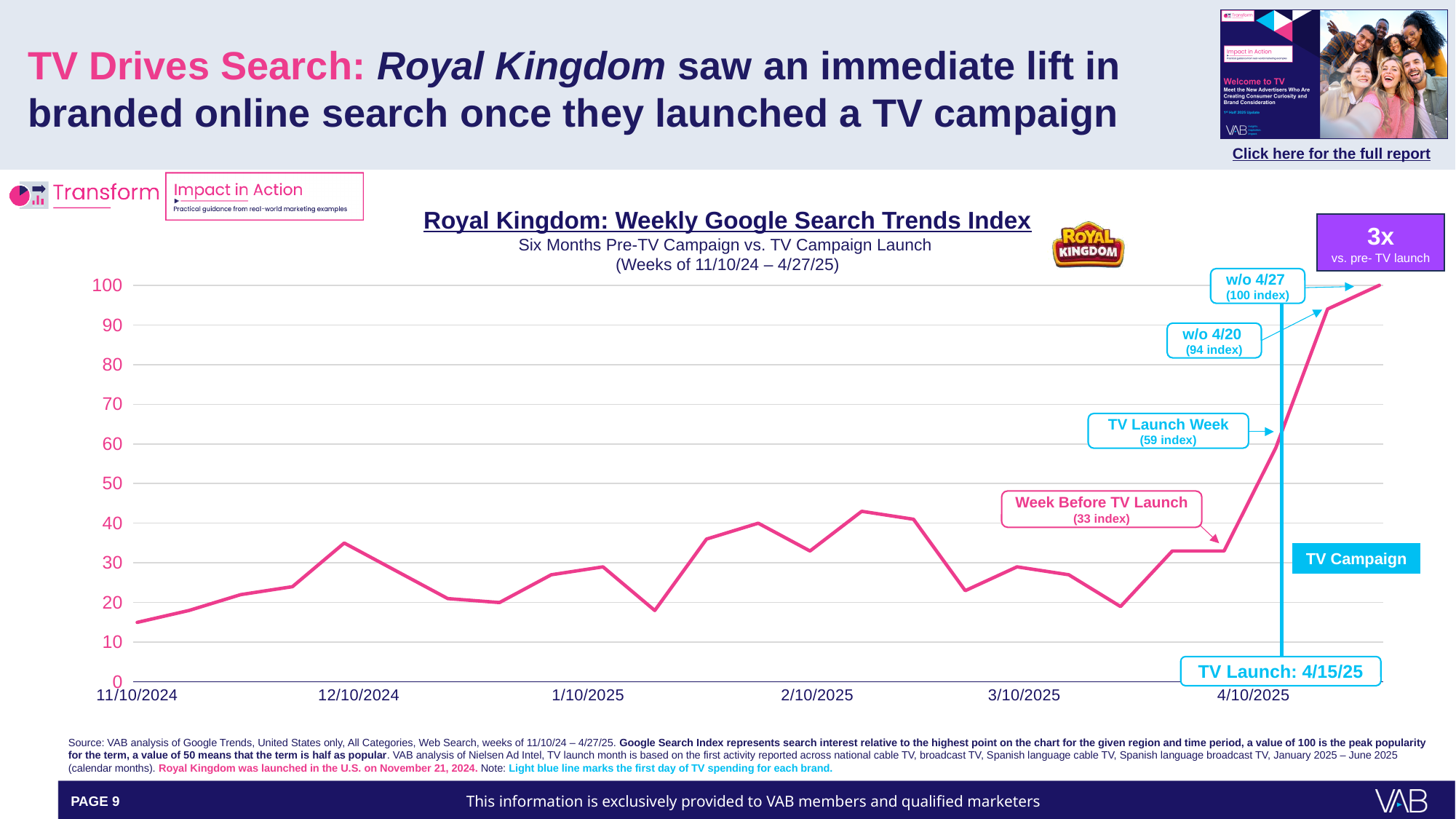
What is the search index value for the TV Launch Week? 59 index By how much did the search index rise from the Week Before TV Launch to the TV Launch Week? 26 Which week has the highest search index value on the chart? w/o 4/27 What kind of chart is shown on the slide? Line chart What is the search index value for the week of 4/20? 94 index Is the search index value at 11/10/2024 greater or less than 20? less What is the search index value for the Week Before TV Launch? 33 index What is the search index value for the week of 4/27? 100 index Which is larger, the index for the week of 4/20 or the TV Launch Week? w/o 4/20 What TV launch date is marked on the chart? 4/15/25 What is the difference between the index for the week of 4/27 and the week of 4/20? 6 Does the search index rise or fall from the TV Launch Week to the week of 4/27? Rise